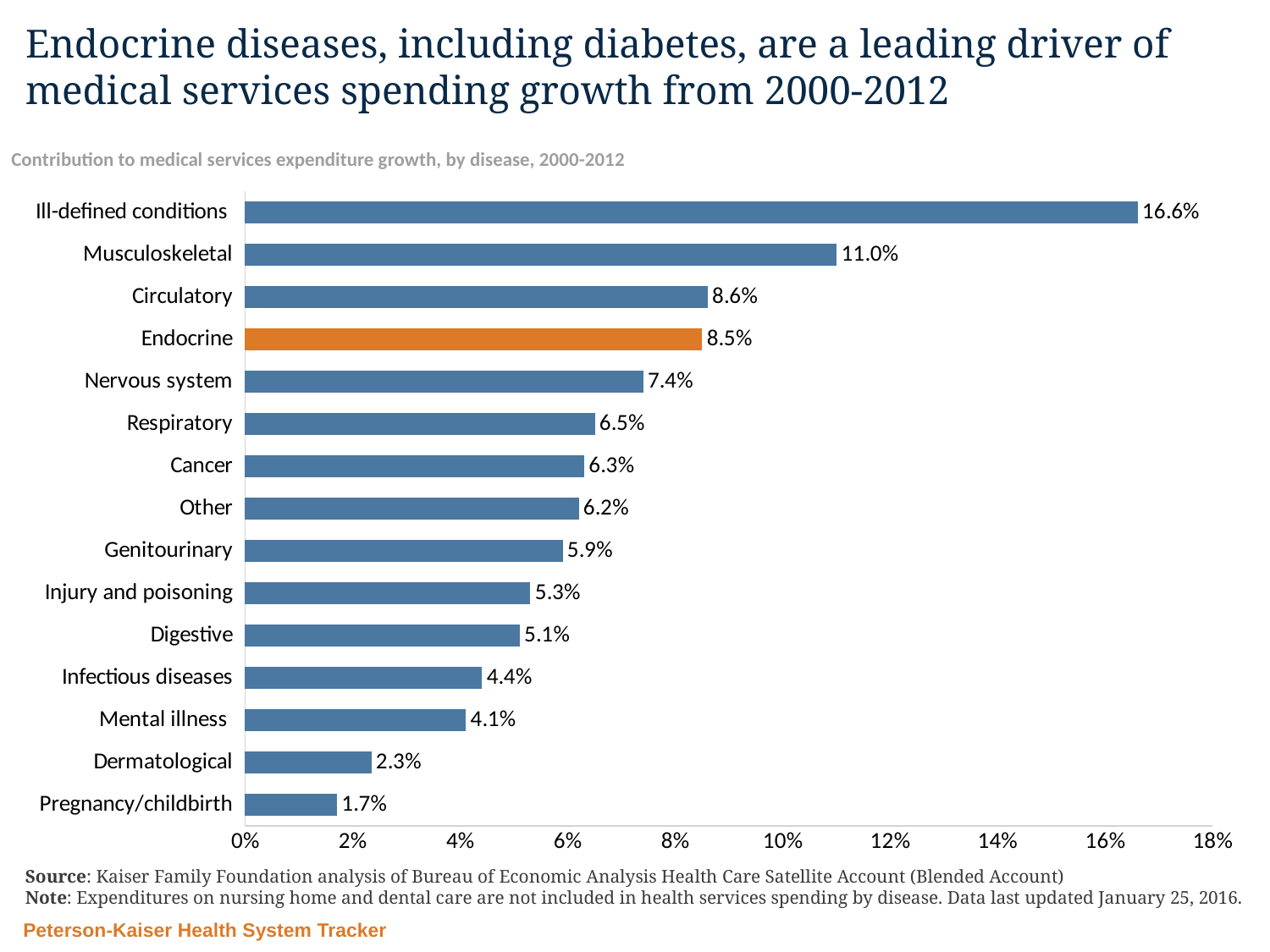
What is the contribution to medical services expenditure growth for Endocrine? 8.5% What is the difference between the values for Ill-defined conditions and Musculoskeletal? 5.6% What is the difference between the values for Circulatory and Endocrine? 0.1% Is the value for Musculoskeletal greater or less than 10%? greater Which has a larger value, Mental illness or Dermatological? Mental illness Which bar is highlighted in orange? Endocrine How many disease categories are shown in the chart? 15 What kind of chart is shown on the slide? Bar chart What is the value shown for Pregnancy/childbirth? 1.7% What is the value shown for Nervous system? 7.4% Which disease category has the highest contribution to medical services expenditure growth? Ill-defined conditions Which disease category has the lowest contribution to medical services expenditure growth? Pregnancy/childbirth